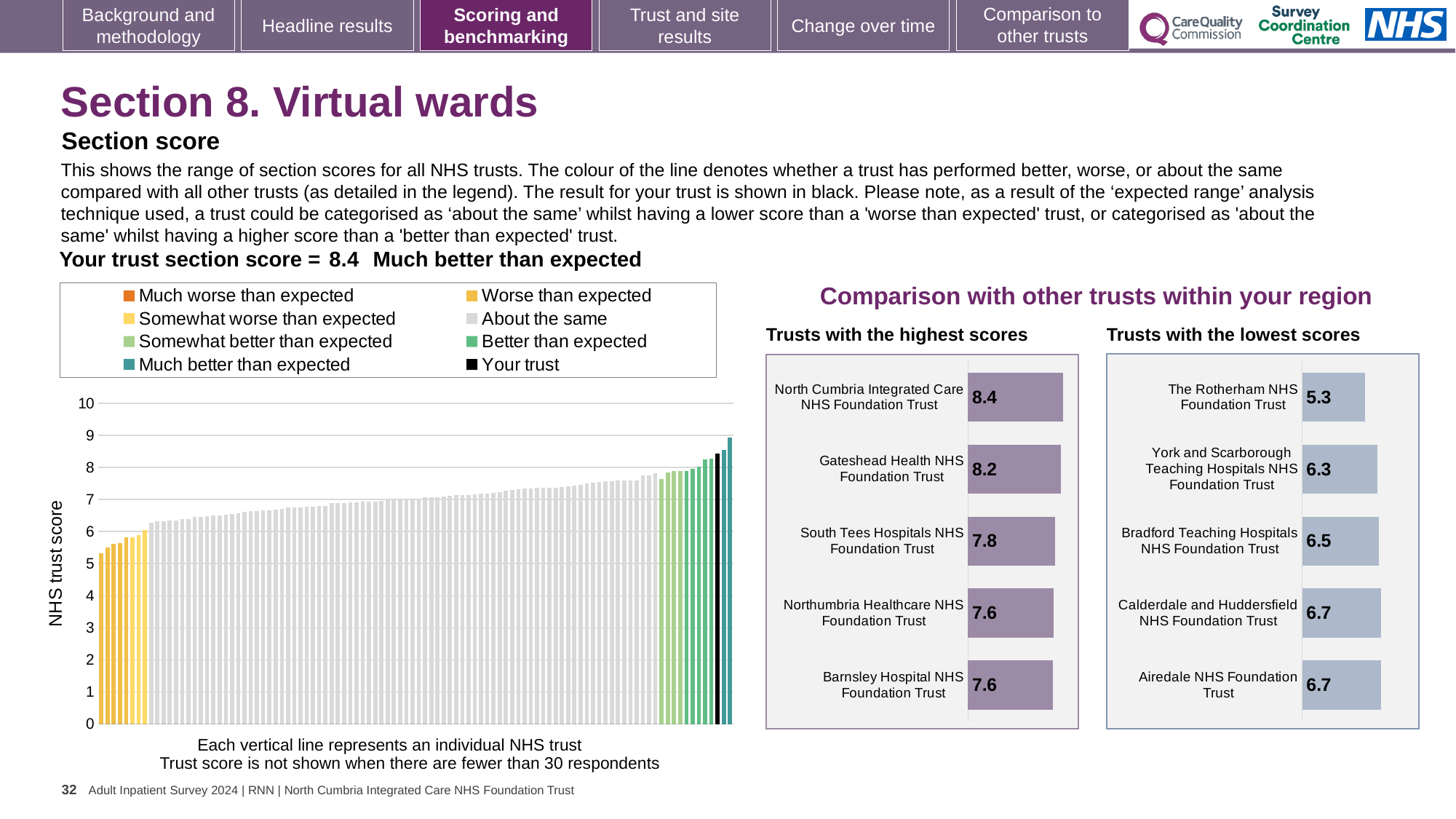
In the 'NHS trust score' chart on the left, do the bar values rise or fall from left to right? Rise In the 'Trusts with the lowest scores' chart, what is the score for Bradford Teaching Hospitals NHS Foundation Trust? 6.5 In the 'NHS trust score' chart on the left, what is the section score for your trust (the black bar)? 8.4 In the 'Trusts with the highest scores' chart, what is the difference between the scores of North Cumbria Integrated Care NHS Foundation Trust and South Tees Hospitals NHS Foundation Trust? 0.6 In the 'Trusts with the lowest scores' chart, which trust has the lowest score? The Rotherham NHS Foundation Trust In the 'Trusts with the highest scores' chart, which trust has the highest score? North Cumbria Integrated Care NHS Foundation Trust How many entries does the legend of the 'NHS trust score' chart on the left list? 8 In the 'Trusts with the lowest scores' chart, what is the difference between the scores of York and Scarborough Teaching Hospitals NHS Foundation Trust and The Rotherham NHS Foundation Trust? 1.0 In the 'Trusts with the highest scores' chart, what is the score for Gateshead Health NHS Foundation Trust? 8.2 How many trusts are shown in the 'Trusts with the lowest scores' chart? 5 Which has the higher score: Gateshead Health NHS Foundation Trust in the highest scores chart or Calderdale and Huddersfield NHS Foundation Trust in the lowest scores chart? Gateshead Health NHS Foundation Trust What kind of chart is the large 'NHS trust score' chart on the left of the slide? Bar chart